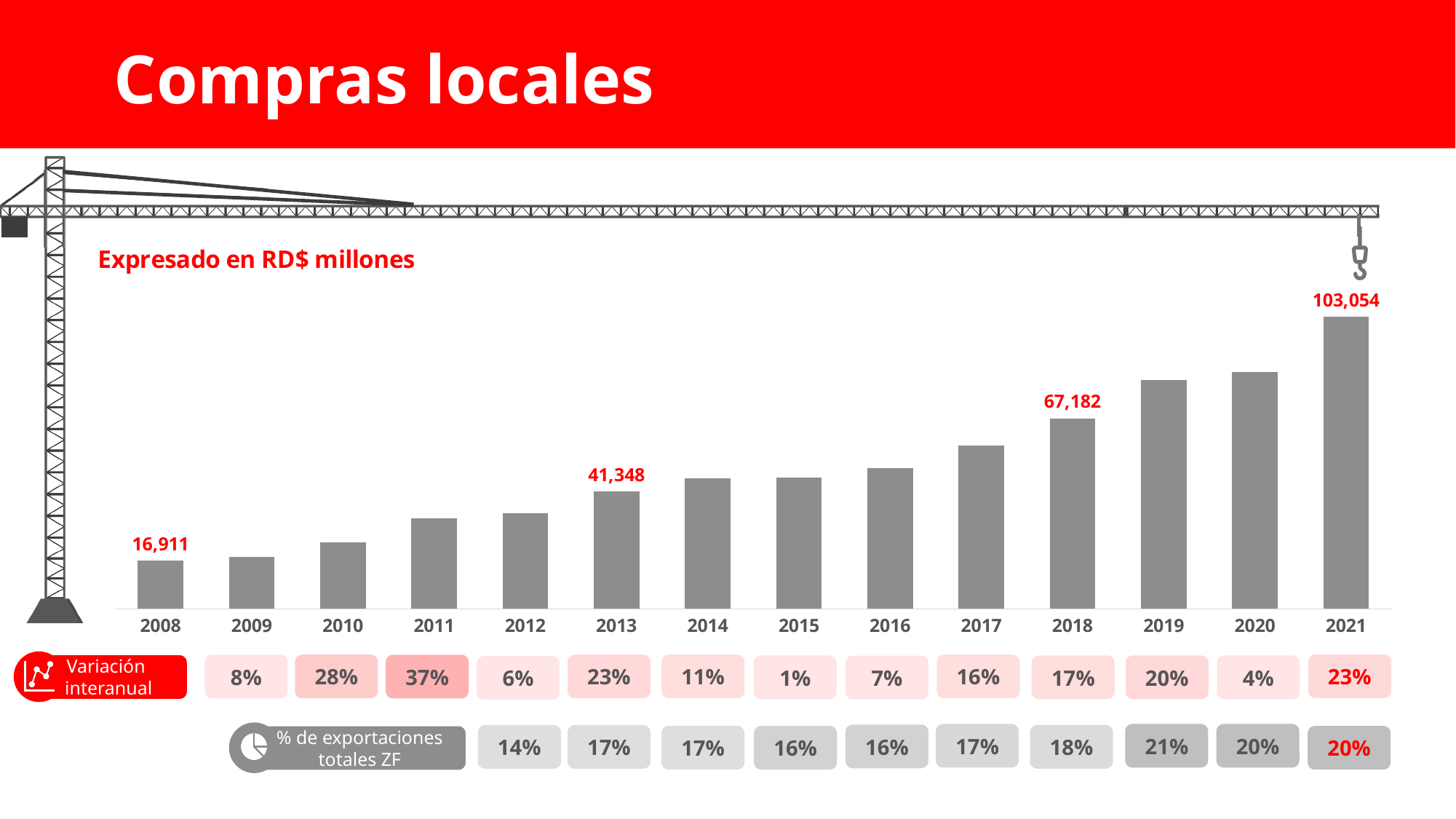
How many years are shown on the x axis of the chart? 14 What is the value of local purchases for 2013? 41,348 Which is larger, the value for 2013 or the value for 2018? 2018 What is the value of local purchases for 2008? 16,911 What is the value of local purchases for 2018? 67,182 What is the value of local purchases for 2021? 103,054 What type of chart is shown on the slide? bar chart What is the difference between the 2021 value and the 2018 value? 35,872 Which year has the highest bar in the chart? 2021 Do the bar values generally rise or fall from 2008 to 2021? rise In what unit are the values in the chart expressed, according to the subtitle? RD$ millones Which year has the lowest bar in the chart? 2008